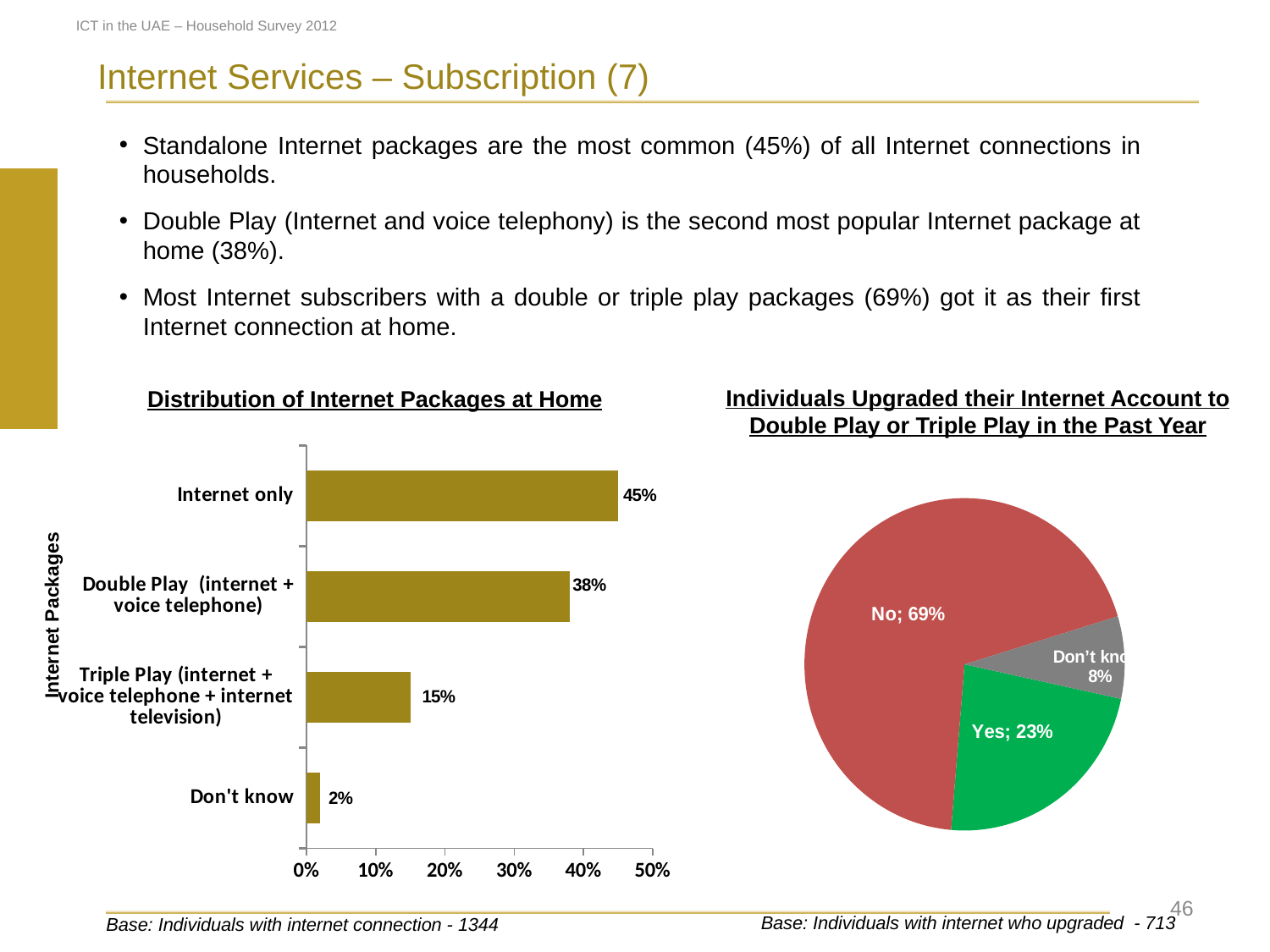
In the 'Distribution of Internet Packages at Home' chart, what is the value for Internet only? 45% In the pie chart 'Individuals Upgraded their Internet Account to Double Play or Triple Play in the Past Year', which slice is the largest? No In the 'Distribution of Internet Packages at Home' chart, which category has the highest value? Internet only What kind of chart is 'Distribution of Internet Packages at Home'? Bar chart In the pie chart 'Individuals Upgraded their Internet Account to Double Play or Triple Play in the Past Year', what share is Yes? 23% In the 'Distribution of Internet Packages at Home' chart, which is larger: Double Play or Triple Play? Double Play In the 'Distribution of Internet Packages at Home' chart, how many categories are shown? 4 In the 'Distribution of Internet Packages at Home' chart, which category has the lowest value? Don't know In the 'Distribution of Internet Packages at Home' chart, what is the value for Triple Play (internet + voice telephone + internet television)? 15% In the 'Distribution of Internet Packages at Home' chart, what is the difference between Internet only and Double Play (internet + voice telephone)? 7% What kind of chart is 'Individuals Upgraded their Internet Account to Double Play or Triple Play in the Past Year'? Pie chart In the pie chart 'Individuals Upgraded their Internet Account to Double Play or Triple Play in the Past Year', what share is No? 69%